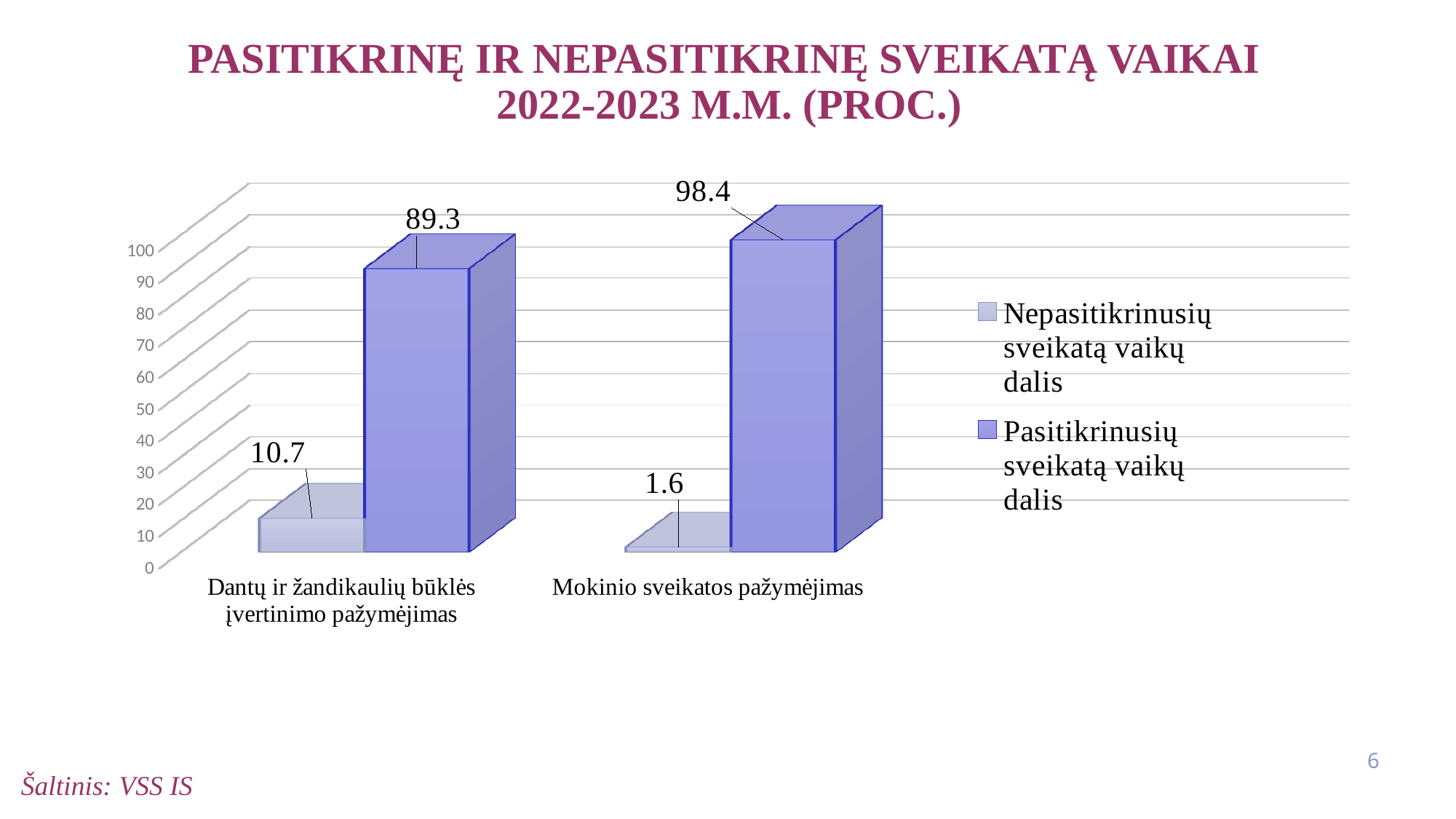
What kind of chart is shown on the slide? Bar chart Which category has the lowest value for 'Nepasitikrinusių sveikatą vaikų dalis'? Mokinio sveikatos pažymėjimas What is the source cited at the bottom of the slide? VSS IS What is the value for 'Nepasitikrinusių sveikatą vaikų dalis' in the 'Dantų ir žandikaulių būklės įvertinimo pažymėjimas' category? 10.7 What is the value for 'Pasitikrinusių sveikatą vaikų dalis' in the 'Dantų ir žandikaulių būklės įvertinimo pažymėjimas' category? 89.3 What is the difference between the 'Pasitikrinusių sveikatą vaikų dalis' values for 'Mokinio sveikatos pažymėjimas' and 'Dantų ir žandikaulių būklės įvertinimo pažymėjimas'? 9.1 What is the value for 'Nepasitikrinusių sveikatą vaikų dalis' in the 'Mokinio sveikatos pažymėjimas' category? 1.6 Which category has the highest value for 'Pasitikrinusių sveikatą vaikų dalis'? Mokinio sveikatos pažymėjimas Which is larger in the 'Dantų ir žandikaulių būklės įvertinimo pažymėjimas' category: 'Nepasitikrinusių sveikatą vaikų dalis' or 'Pasitikrinusių sveikatą vaikų dalis'? Pasitikrinusių sveikatą vaikų dalis How many series does the legend list? 2 How many categories are shown on the x axis? 2 What is the value for 'Pasitikrinusių sveikatą vaikų dalis' in the 'Mokinio sveikatos pažymėjimas' category? 98.4